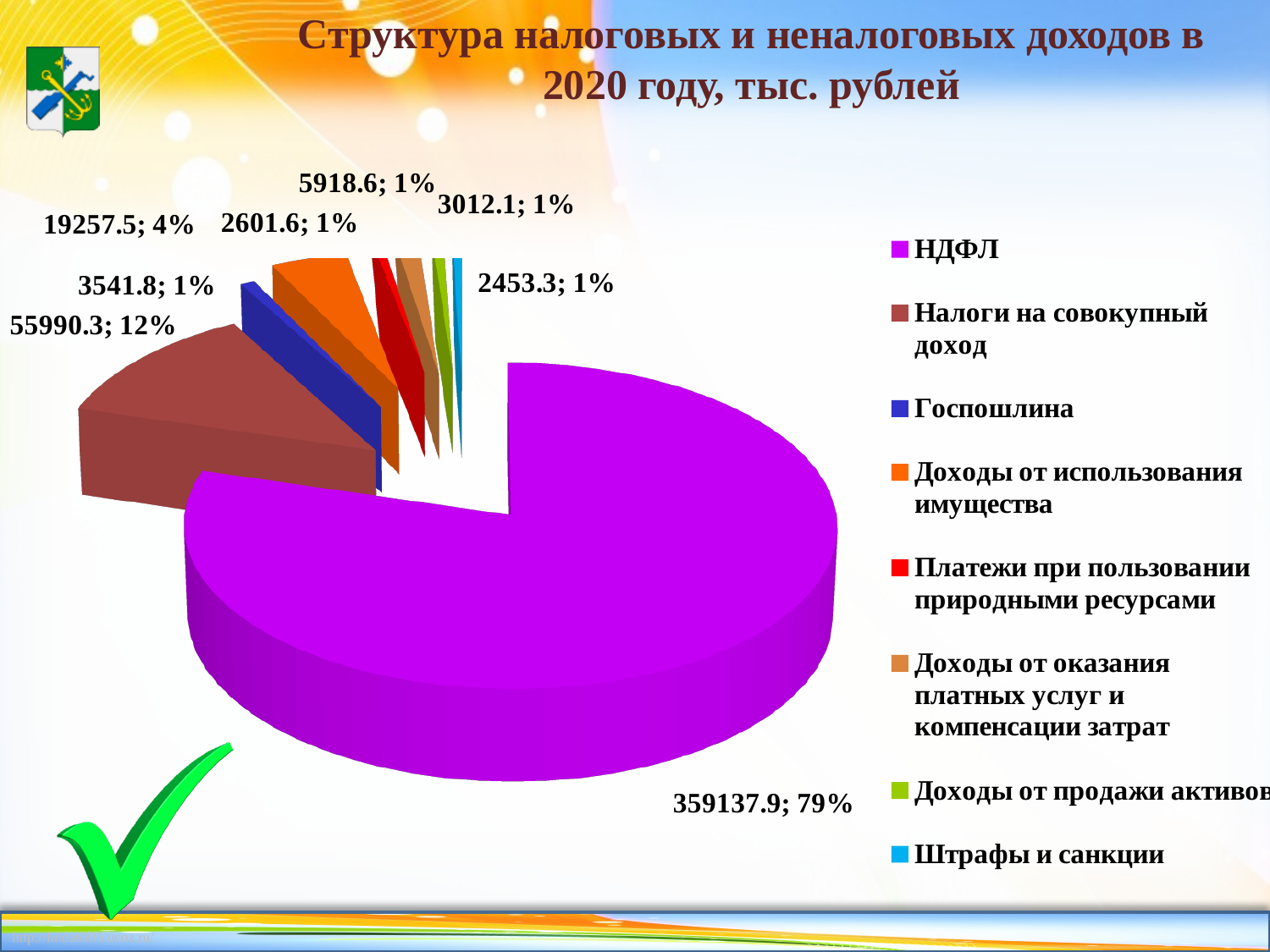
What is the value shown for Госпошлина? 3541.8 What is the difference between the values for НДФЛ and Налоги на совокупный доход? 303147.6 What share of the pie does НДФЛ account for? 79% What is the title of the chart? Структура налоговых и неналоговых доходов в 2020 году, тыс. рублей What is the value shown for НДФЛ? 359137.9 What share of the pie does Госпошлина account for? 1% What is the value shown for Налоги на совокупный доход? 55990.3 Which category has the largest slice of the pie? НДФЛ What share of the pie does Налоги на совокупный доход account for? 12% What kind of chart is shown on the slide? pie chart How many categories does the legend list? 8 Which is larger, НДФЛ or Налоги на совокупный доход? НДФЛ